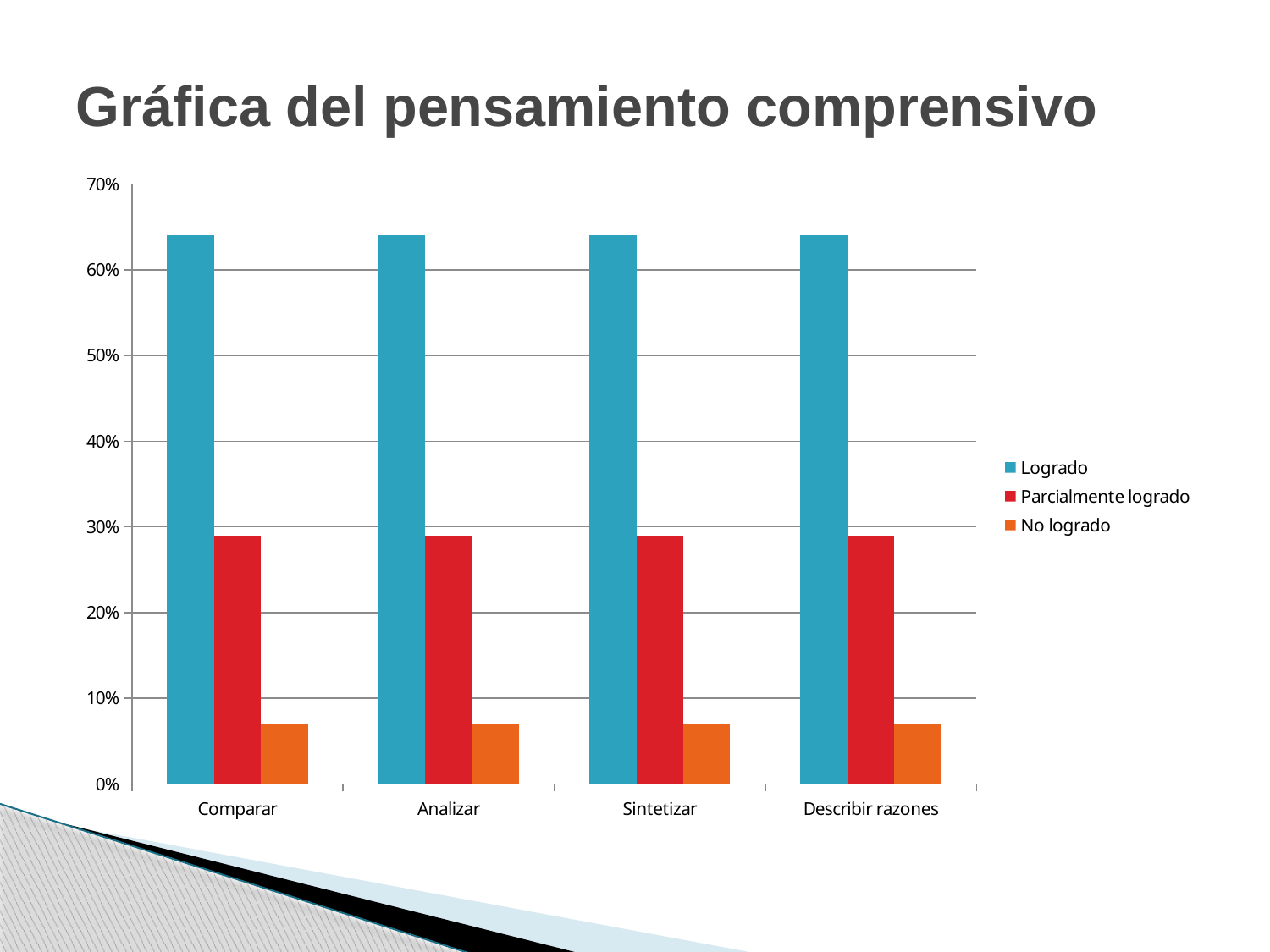
Which series is shown in red? Parcialmente logrado For Analizar, which is larger: Parcialmente logrado or No logrado? Parcialmente logrado Is the value for No logrado in Comparar greater or less than 10%? less Is the value for Logrado in Analizar greater or less than 60%? greater How many categories are shown on the x axis? 4 How many series does the legend list? 3 What is the title of the slide? Gráfica del pensamiento comprensivo Which series has the lowest value for Sintetizar? No logrado Is the value for Parcialmente logrado in Sintetizar greater or less than 20%? greater What kind of chart is shown on the slide? bar chart Which series has the highest value for Comparar? Logrado